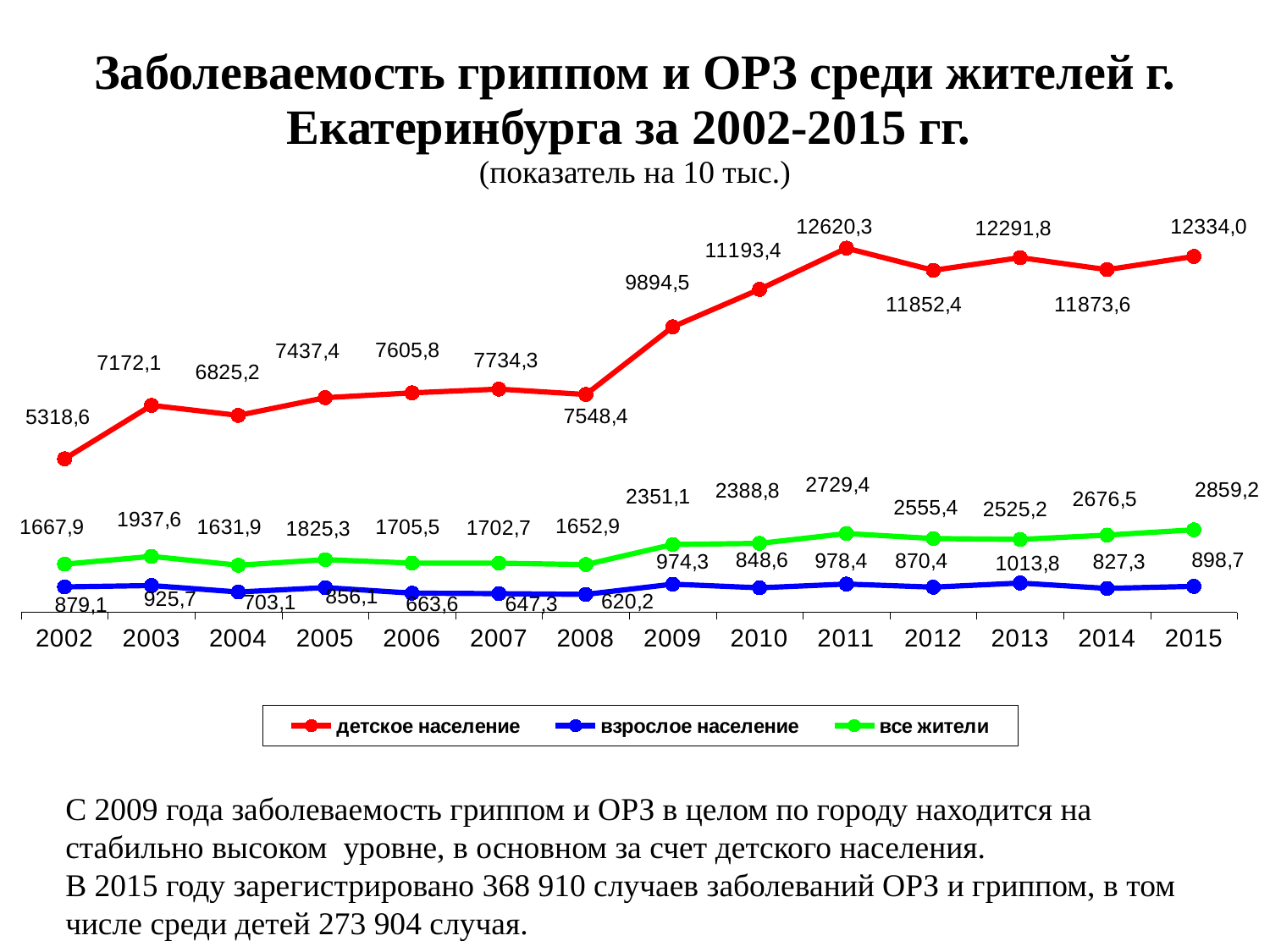
What is the value for все жители in 2015? 2859,2 In which year is the value for детское население the highest? 2011 What is the difference between the детское население values in 2015 and 2002? 7015,4 How many years are plotted along the x axis? 14 In which year is the value for все жители the lowest? 2004 Which is larger: the взрослое население value in 2013 or in 2014? 2013 What is the value for детское население in 2011? 12620,3 What is the value for взрослое население in 2008? 620,2 In which year is the value for взрослое население the lowest? 2008 What type of chart is shown on the slide? line chart How many series does the legend list? 3 Which series is shown in red in the legend? детское население